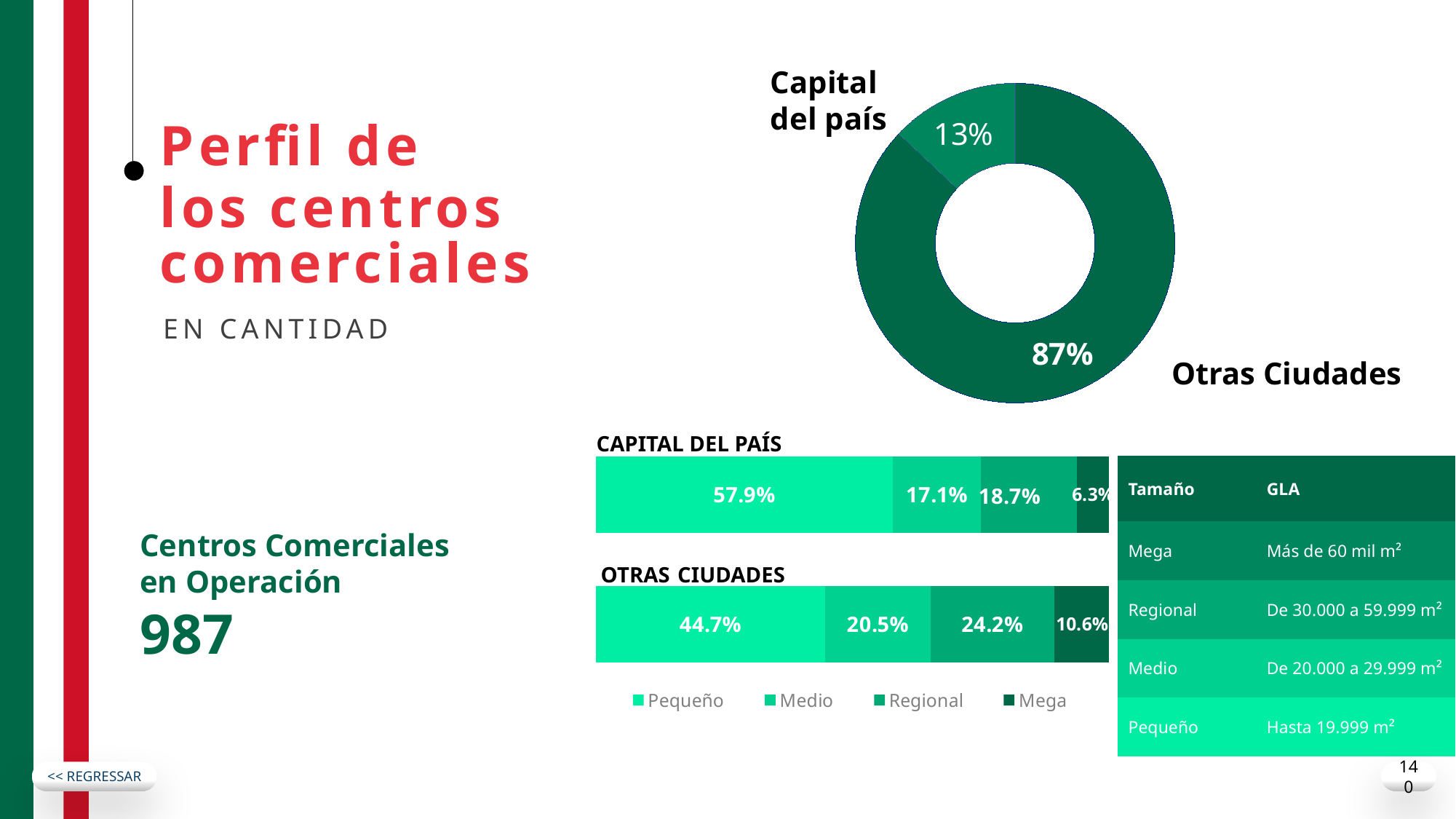
In the stacked bar titled CAPITAL DEL PAÍS, what is the value for Mega? 6.3% In the donut chart at the top, which segment is larger, Capital del país or Otras Ciudades? Otras Ciudades In the stacked bar titled CAPITAL DEL PAÍS, what is the value for Pequeño? 57.9% What is the difference between the Pequeño share in CAPITAL DEL PAÍS and the Pequeño share in OTRAS CIUDADES? 13.2% In the donut chart at the top, how many segments are shown? 2 In the donut chart at the top, what share is labelled Otras Ciudades? 87% What type of chart is the one at the top showing Capital del país and Otras Ciudades? Donut (pie) chart In the stacked bar titled OTRAS CIUDADES, which category has the smallest share? Mega In the stacked bar titled CAPITAL DEL PAÍS, which is larger, Medio or Regional? Regional How many categories does the legend below the stacked bars list? 4 In the stacked bar titled OTRAS CIUDADES, what is the value for Regional? 24.2% In the donut chart at the top, what share of shopping centres is in the capital of the country (Capital del país)? 13%